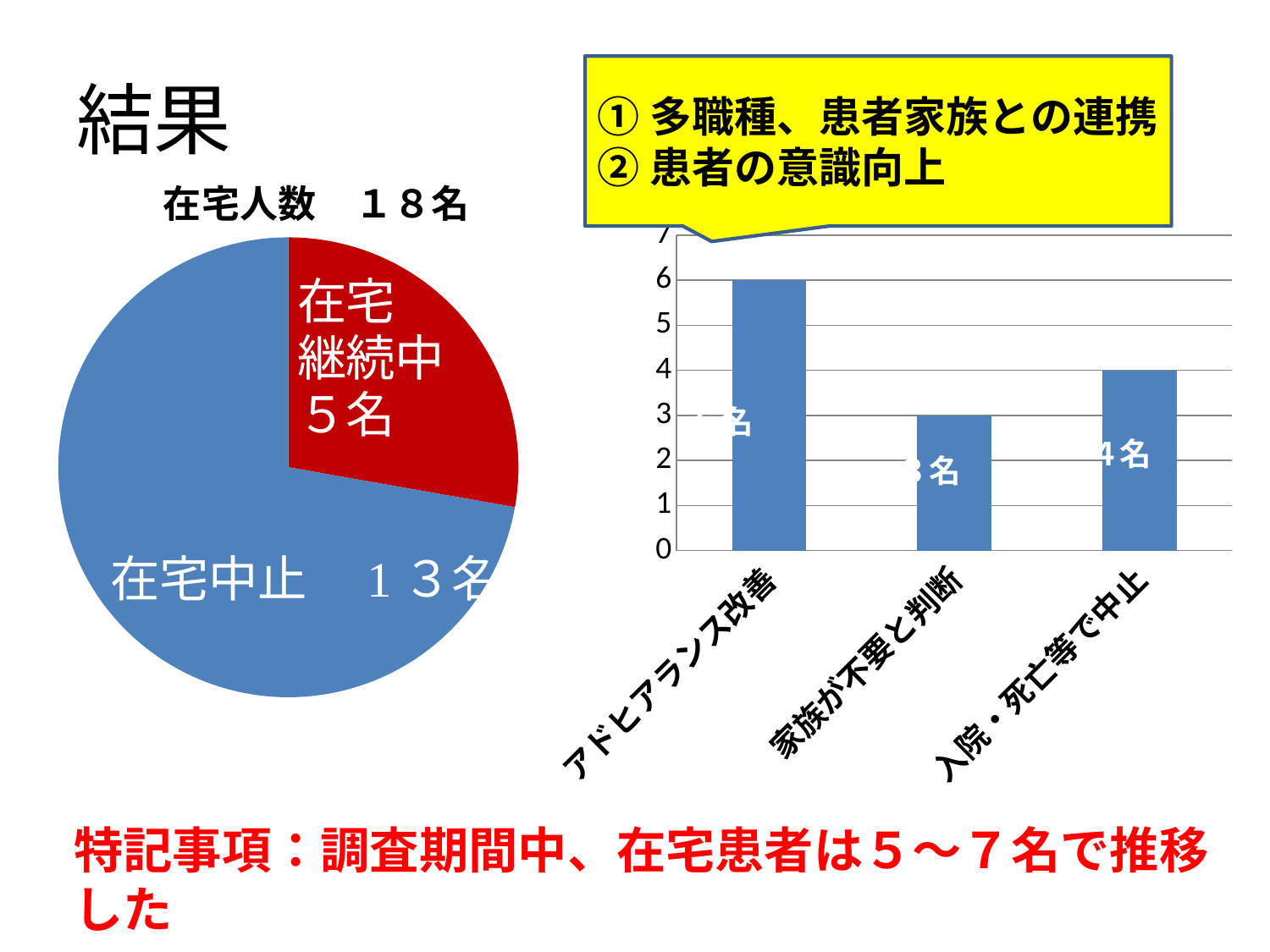
In the bar chart on the right, what is the value for 家族が不要と判断? 3名 In the bar chart on the right, what is the value for 入院・死亡等で中止? 4名 How many categories are shown in the bar chart on the right? 3 In the pie chart on the left, what colour is the 在宅継続中 slice? Red In the bar chart on the right, which category has the highest value? アドヒアランス改善 In the pie chart on the left, how many people are labelled 在宅継続中? 5名 In the pie chart on the left, what is the difference between the 在宅中止 and 在宅継続中 counts? 8名 What kind of chart is the chart on the right of the slide? Bar chart In the pie chart on the left, how many people are labelled 在宅中止? 13名 What total number of people is given in the title of the pie chart on the left? 18名 In the bar chart on the right, which category has the lowest value? 家族が不要と判断 In the pie chart on the left, which slice is larger, 在宅継続中 or 在宅中止? 在宅中止